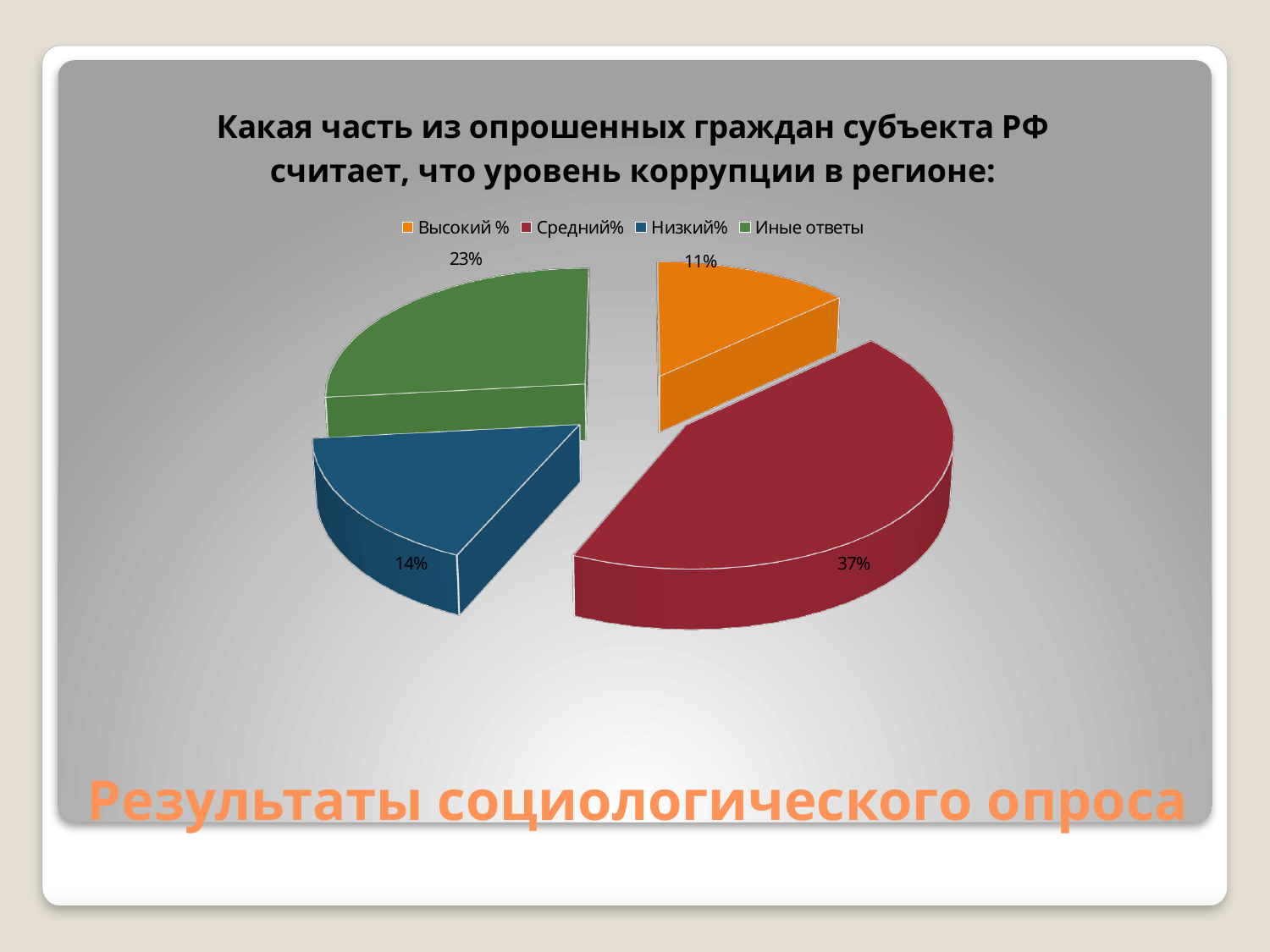
How many slices does the pie chart have? 4 What colour is the "Средний%" slice? red Which slice of the pie chart has the largest value? Средний% How many entries does the legend list? 4 What percentage is shown for the "Иные ответы" slice? 23% Which is larger, the "Низкий%" slice or the "Иные ответы" slice? Иные ответы What kind of chart is shown on the slide? pie chart What percentage is shown for the "Низкий%" slice? 14% Which slice of the pie chart has the smallest value? Высокий % What percentage is shown for the "Средний%" slice? 37% What percentage is shown for the "Высокий %" slice? 11% What is the difference between the "Средний%" and "Иные ответы" values? 14%